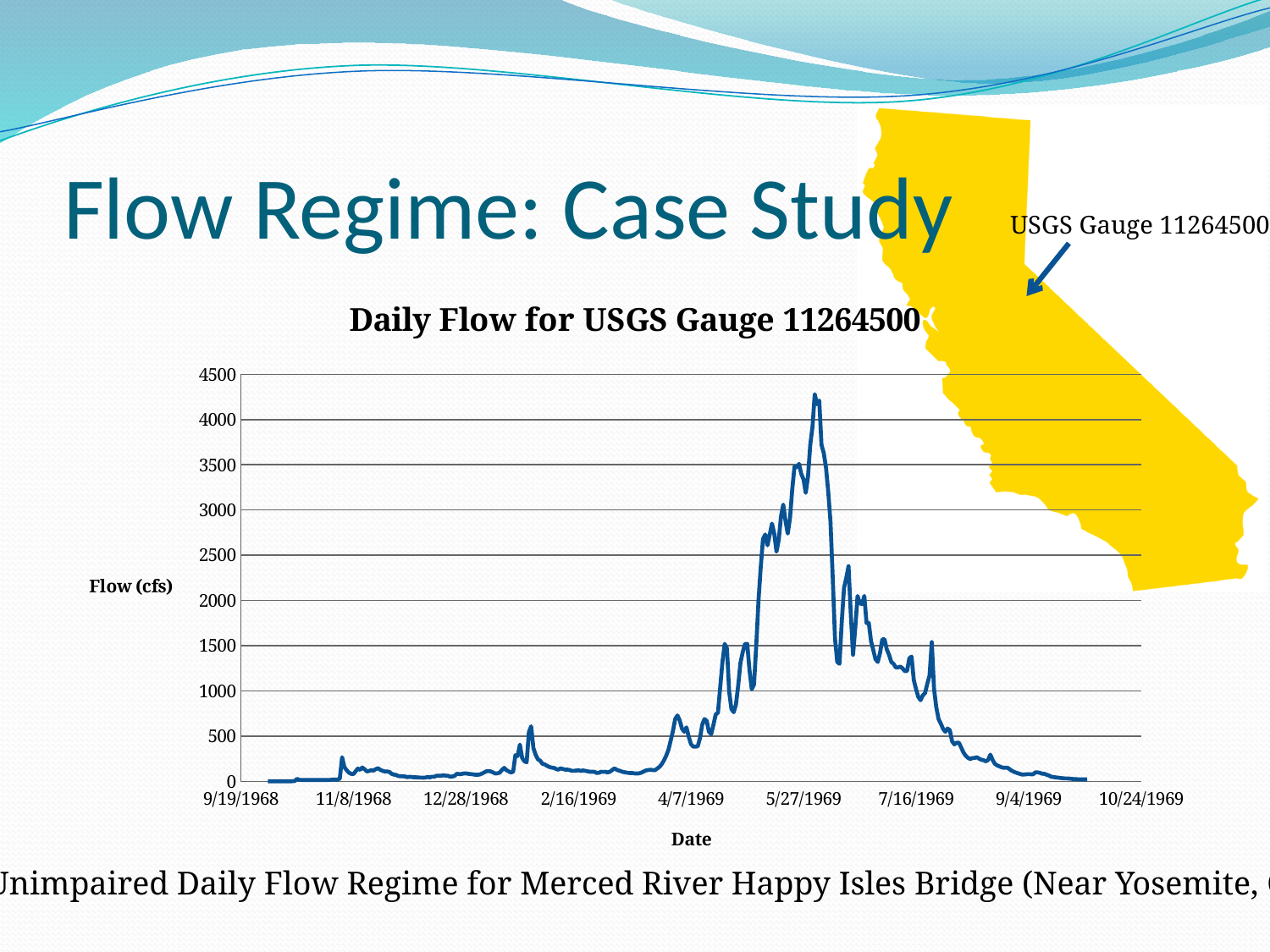
Is the flow value at 11/8/1968 greater or less than 1000? less What is the highest value shown on the vertical axis of the chart? 4500 Which is larger, the flow around 5/27/1969 or the flow around 11/8/1968? the flow around 5/27/1969 Is the flow value at 12/28/1968 greater or less than 500? less What kind of chart is shown on the slide? line chart Does the flow rise or fall between 4/7/1969 and 5/27/1969? rise Is the peak flow value on the chart greater or less than 4000? greater Does the flow rise or fall between 7/16/1969 and 9/4/1969? fall What is the title of the chart? Daily Flow for USGS Gauge 11264500 Between which two labelled dates on the x axis does the highest flow occur? 5/27/1969 and 7/16/1969 What is the label of the vertical axis of the chart? Flow (cfs)